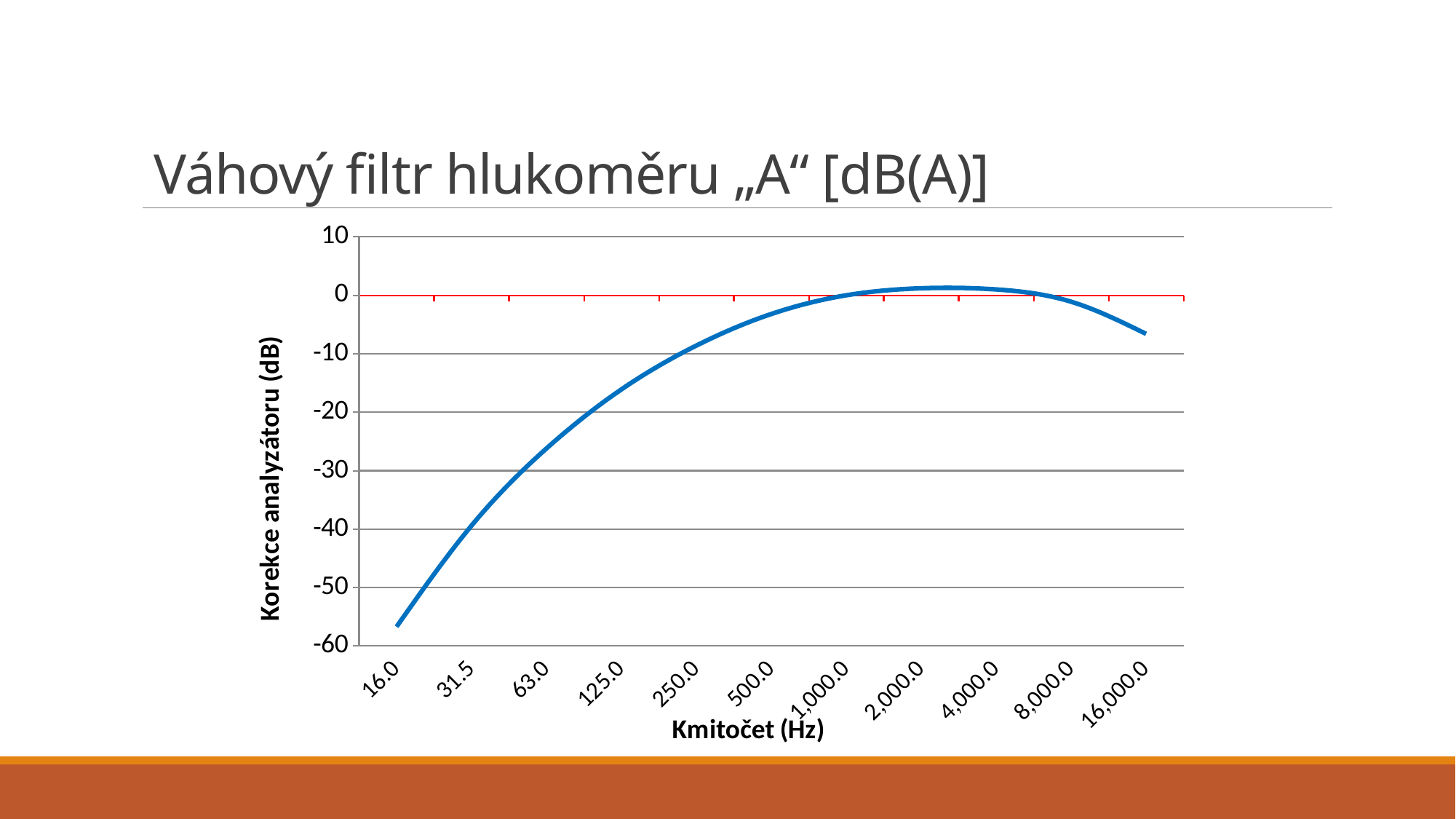
Is the value for 31.5 greater or less than -30? less Is the value for 16,000.0 greater or less than 0? less Which has the larger correction value, 16.0 or 16,000.0? 16,000.0 Is the value for 16.0 greater or less than -50? less Does the correction value rise or fall from 16.0 to 1,000.0? rise What is the label of the y axis? Korekce analyzátoru (dB) How many frequency categories are shown on the x axis? 11 At which frequency is the correction value lowest? 16.0 What is the title of the chart? Váhový filtr hlukoměru „A“ [dB(A)] What kind of chart is shown on the slide? line chart